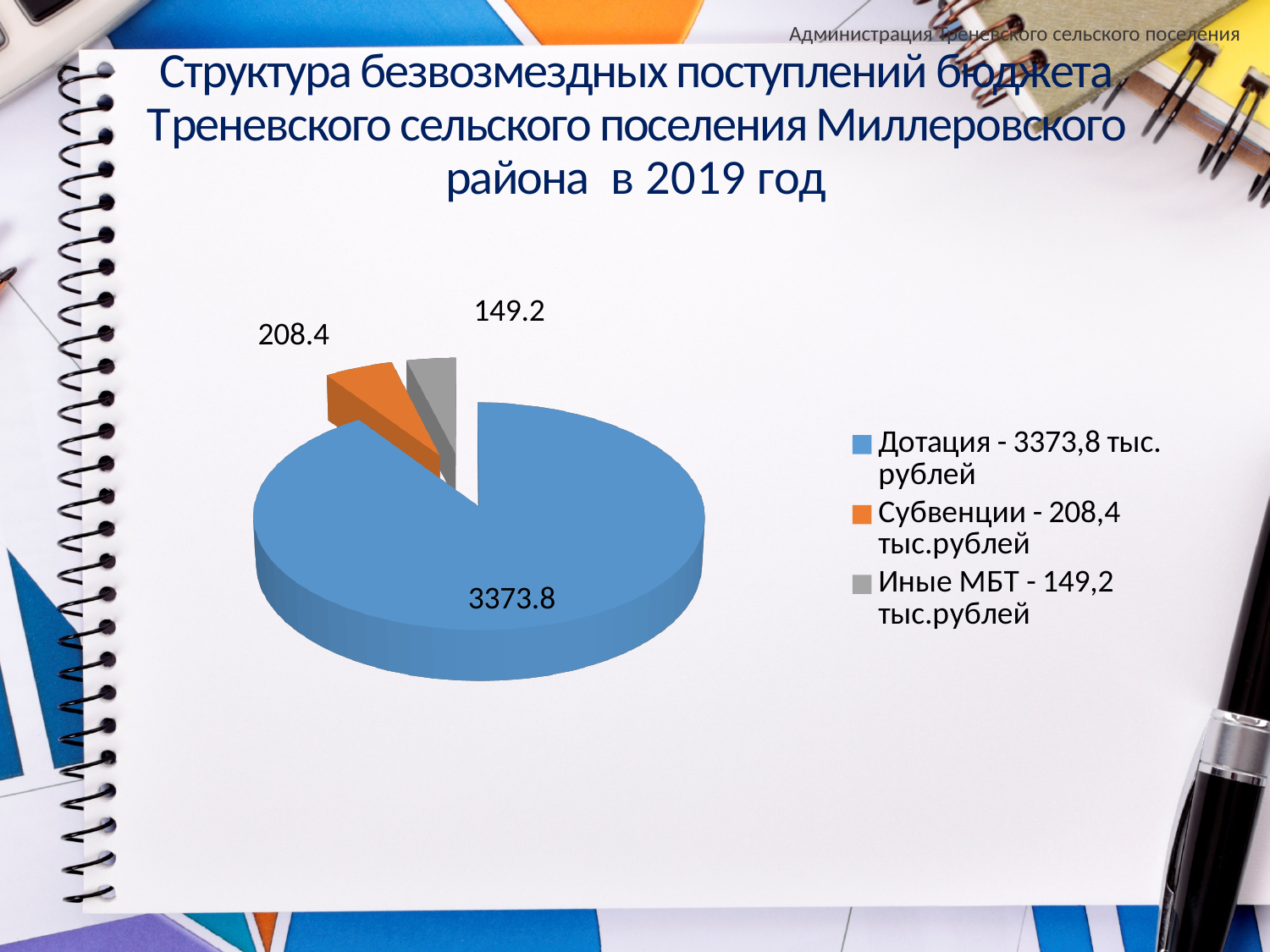
Which category has the largest slice of the pie? Дотация What is the difference between the Дотация value and the Субвенции value? 3165.4 What is the value shown for the Дотация slice? 3373.8 What type of chart is shown on the slide? Pie chart How many slices does the pie chart have? 3 What colour is the Субвенции slice in the pie chart? Orange What is the value shown for the Субвенции slice? 208.4 What is the value shown for the Иные МБТ slice? 149.2 Which is larger, the Субвенции slice or the Иные МБТ slice? Субвенции Which category has the smallest slice of the pie? Иные МБТ What is the total of all three slices in the pie chart? 3731.4 What is the difference between the Субвенции value and the Иные МБТ value? 59.2